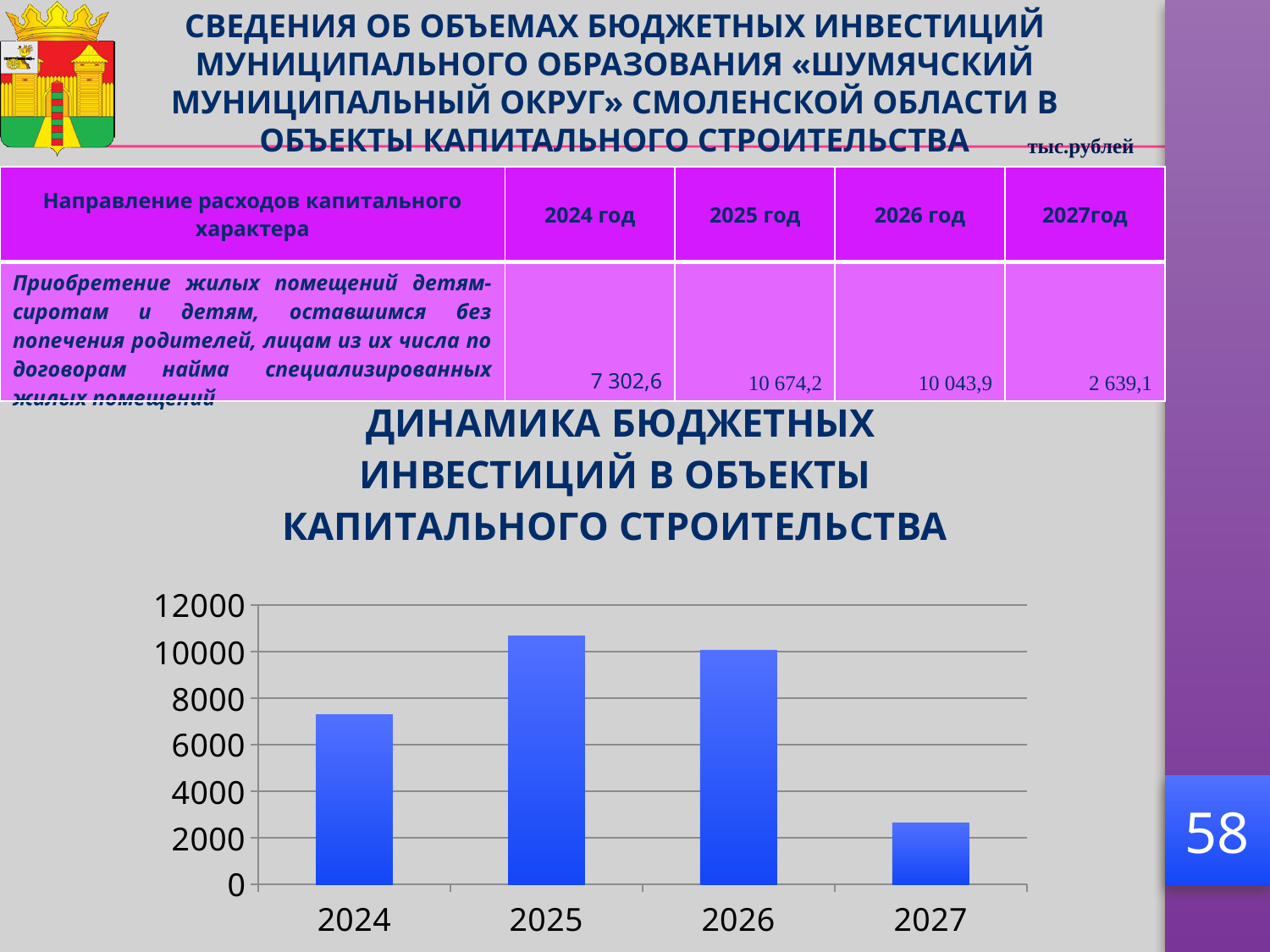
Which year has the highest bar on the chart? 2025 Which year has the lowest bar on the chart? 2027 Is the value for 2027 greater or less than 4000? less Which is larger, the value for 2024 or the value for 2026? 2026 Is the value for 2026 greater or less than 8000? greater Is the value for 2025 greater or less than 10000? greater According to the table on the slide, what is the value for 2025 (thousand rubles)? 10 674,2 Do the values rise or fall from 2025 to 2027 on the chart? fall According to the table on the slide, what is the value for 2027 (thousand rubles)? 2 639,1 How many years (bars) are shown on the chart? 4 What kind of chart is shown on the slide? bar chart